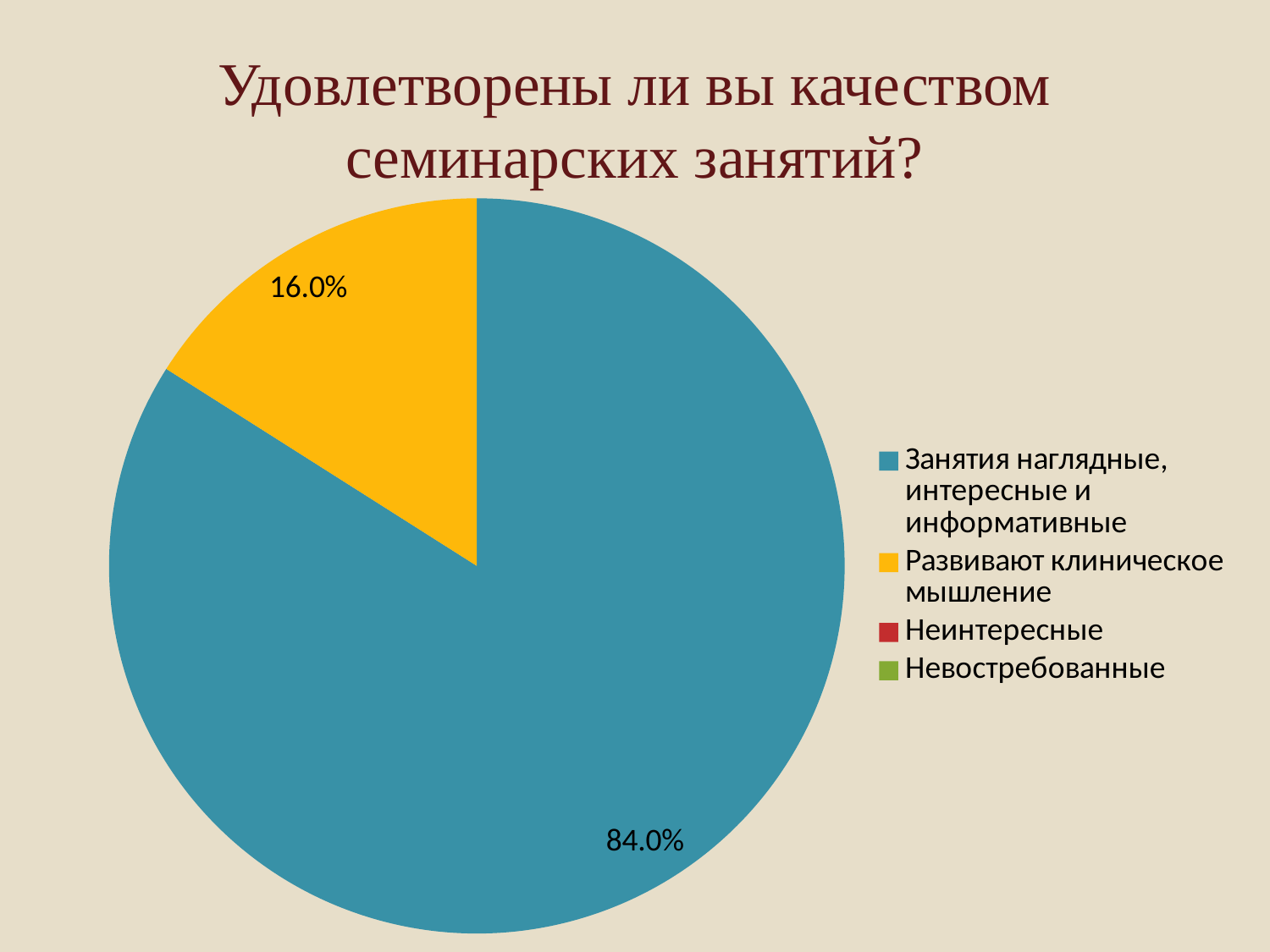
What is the title of the chart? Удовлетворены ли вы качеством семинарских занятий? What is the difference in percentage points between the 84.0% slice and the 16.0% slice? 68.0 percentage points How many entries does the legend list? 4 What share of the pie does the blue slice represent? 84.0% What percentage is shown for the slice "Развивают клиническое мышление"? 16.0% What kind of chart is shown on the slide? Pie chart Which is larger: the slice for "Развивают клиническое мышление" or the slice for "Занятия наглядные, интересные и информативные"? Занятия наглядные, интересные и информативные Which category has the largest slice of the pie? Занятия наглядные, интересные и информативные What percentage is shown for the slice "Занятия наглядные, интересные и информативные"? 84.0% What colour is the slice labelled 16.0%? Yellow How many slices have a percentage label printed on the pie? 2